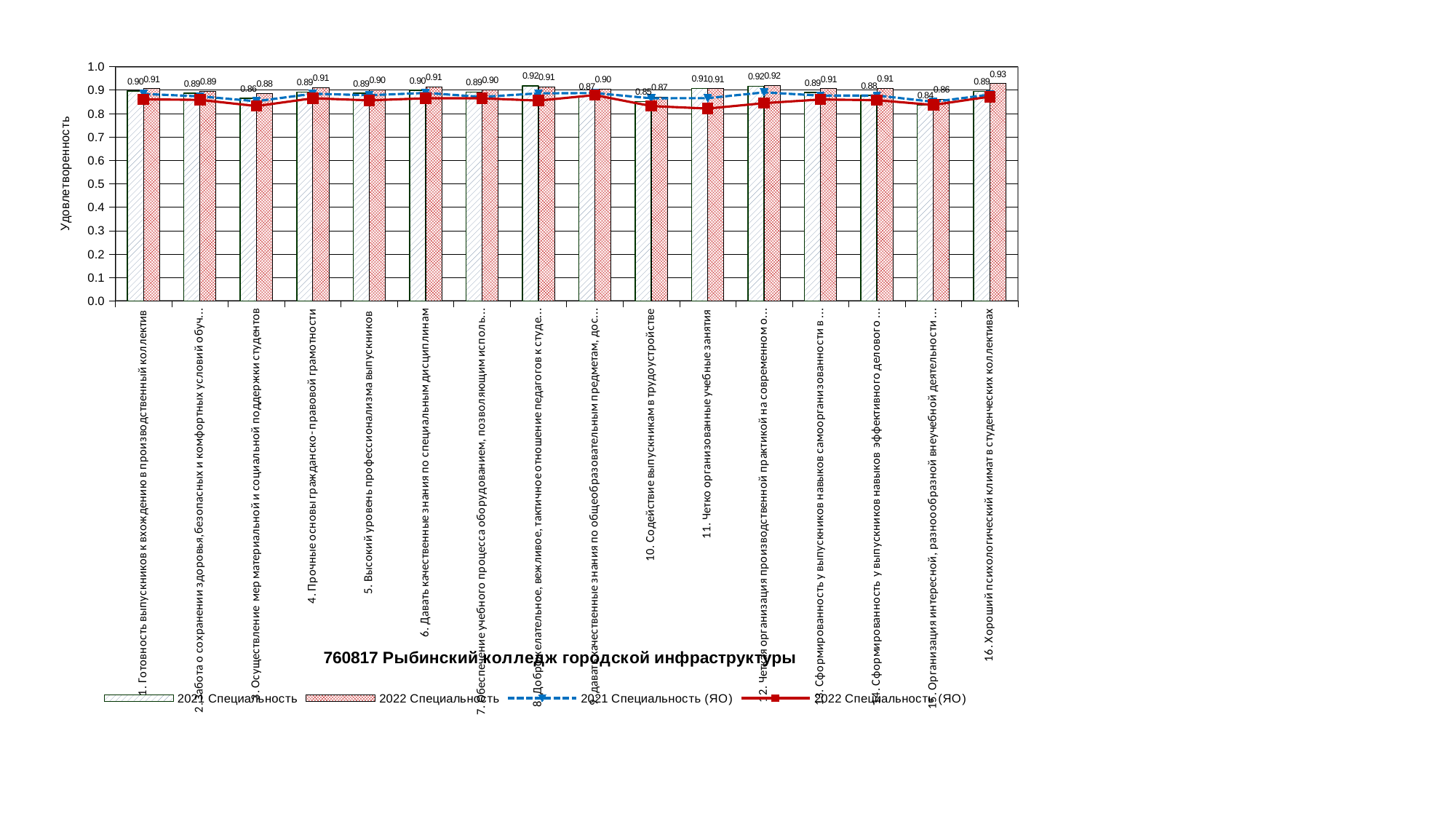
How many series does the legend list? 4 Which category has the lowest 2021 Специальность bar? 15. Организация интересной, разнообразной внеучебной деятельности … What is the value of the 2022 Специальность bar for category "4. Прочные основы гражданско-правовой грамотности"? 0.91 Is the 2021 Специальность value for category "11. Четко организованные учебные занятия" greater or less than 0.8? greater What kind of chart is shown on the slide? Combined bar and line chart For category "3. Осуществление мер материальной и социальной поддержки студентов", which is larger: the 2021 Специальность bar or the 2022 Специальность bar? 2022 Специальность How many categories are shown on the x axis? 16 What is the difference between the 2022 and 2021 Специальность values for category "16. Хороший психологический климат в студенческих коллективах"? 0.04 What is the value of the 2021 Специальность bar for category "10. Содействие выпускникам в трудоустройстве"? 0.85 Which category has the highest 2022 Специальность bar? 16. Хороший психологический климат в студенческих коллективах What is the value of the 2022 Специальность bar for category "16. Хороший психологический климат в студенческих коллективах"? 0.93 What is the label of the vertical axis? Удовлетворенность